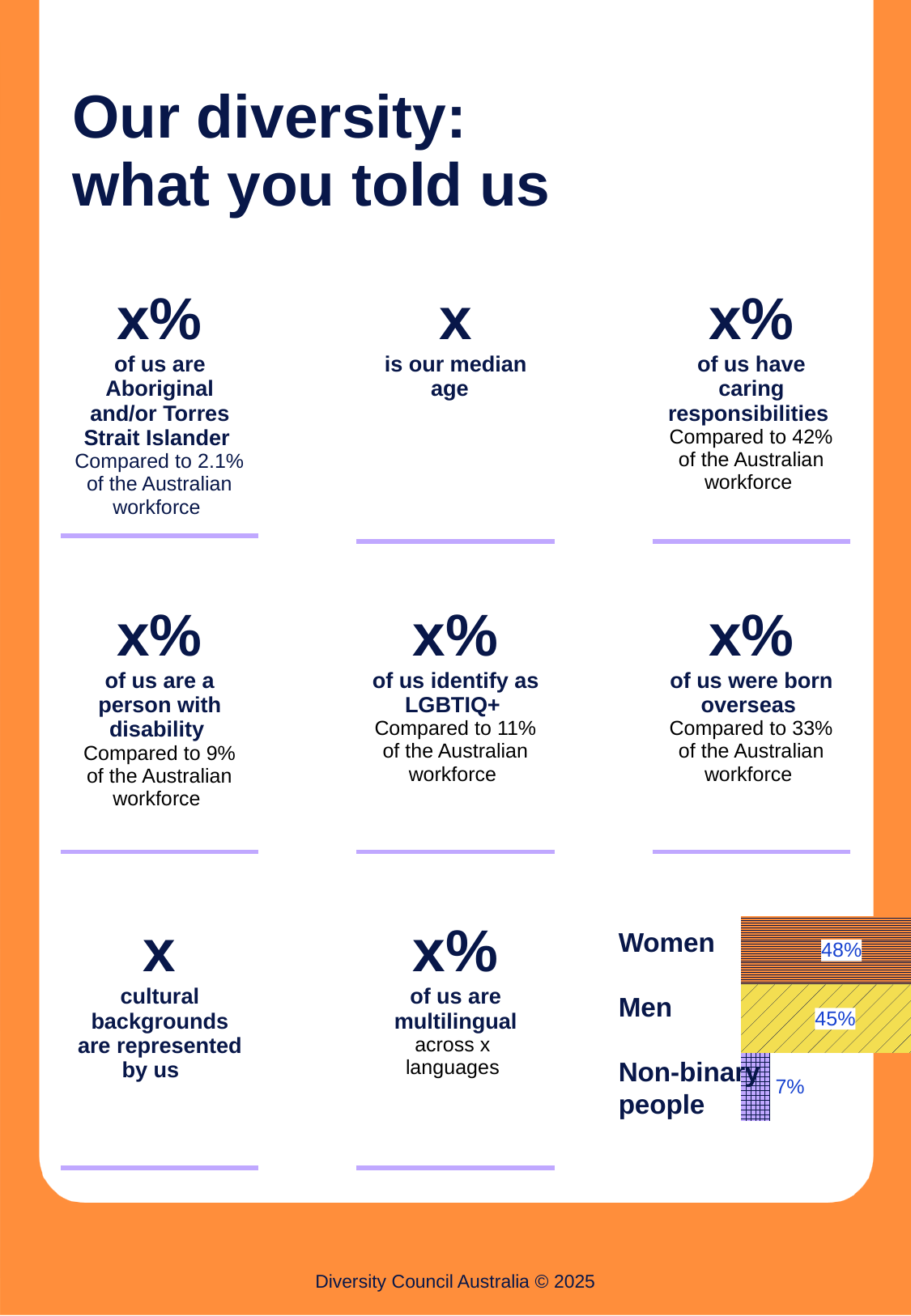
What kind of chart is shown at the bottom right of the slide? bar chart Which category has the highest value in the bar chart? Women What is the total of the three values shown in the bar chart? 100% In the bar chart, is the value for Men larger or smaller than the value for Non-binary people? larger Which category in the bar chart is drawn with a yellow diagonal-striped pattern? Men Which category has the lowest value in the bar chart? Non-binary people What is the difference between the values for Men and Non-binary people in the bar chart? 38% What percentage does the bar chart show for Men? 45% What is the difference between the values for Women and Men in the bar chart? 3% What percentage does the bar chart show for Non-binary people? 7% How many categories are shown in the bar chart? 3 What percentage does the bar chart show for Women? 48%